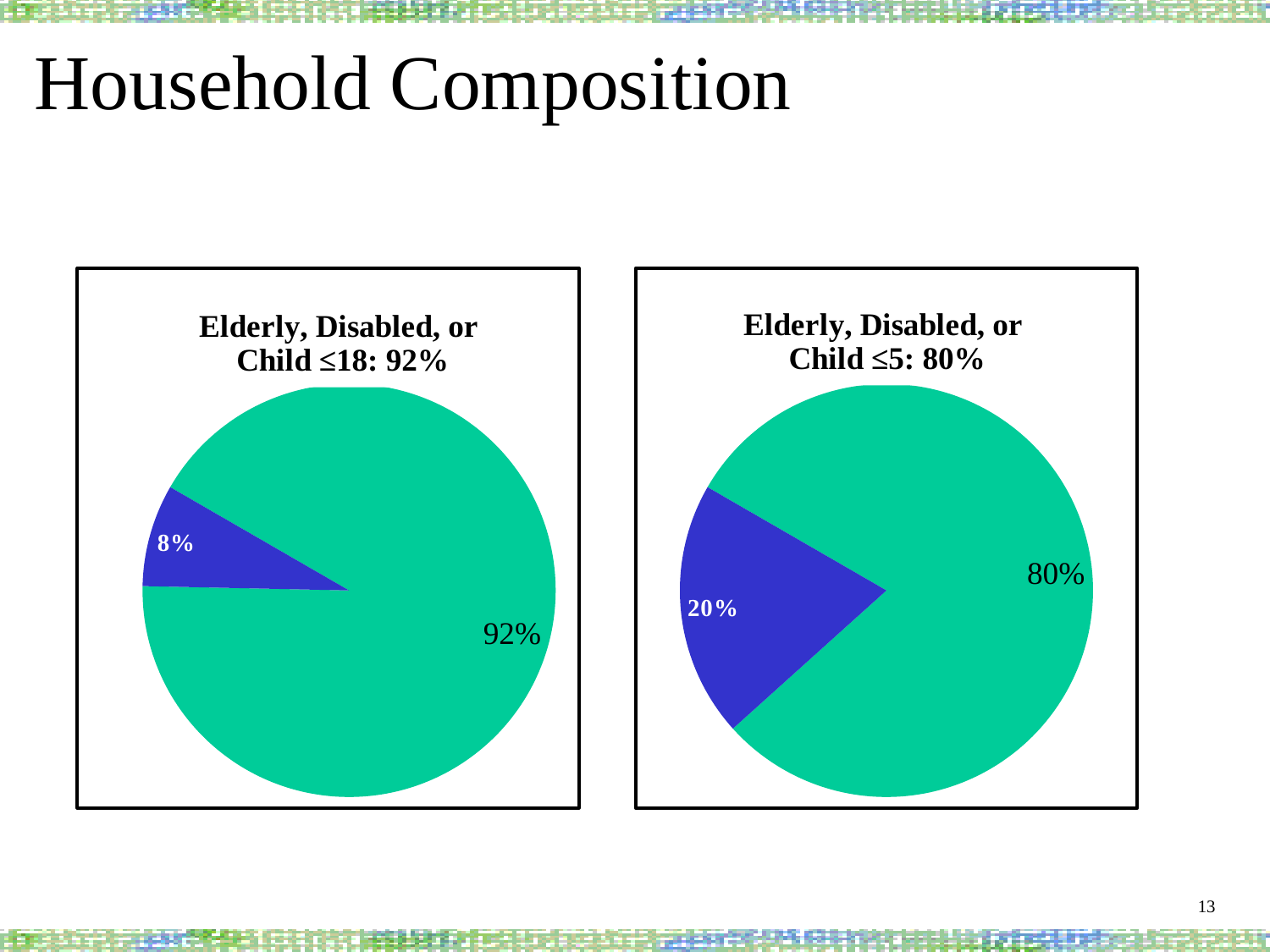
In the right pie chart titled "Elderly, Disabled, or Child ≤5", what share does the larger green slice represent? 80% Which pie chart has the larger blue slice, the left one (Child ≤18) or the right one (Child ≤5)? the right one (Child ≤5) What kind of chart is shown on the left of the slide? pie chart How many slices does the left pie chart have? 2 In the left pie chart titled "Elderly, Disabled, or Child ≤18", what share does the smaller blue slice represent? 8% What is the title of the right pie chart? Elderly, Disabled, or Child ≤5: 80% In the left pie chart titled "Elderly, Disabled, or Child ≤18", what share does the larger green slice represent? 92% In the left pie chart, what is the difference between the two slices' percentages? 84% In the right pie chart, what is the difference between the two slices' percentages? 60% What is the title of the slide? Household Composition How many slices does the right pie chart have? 2